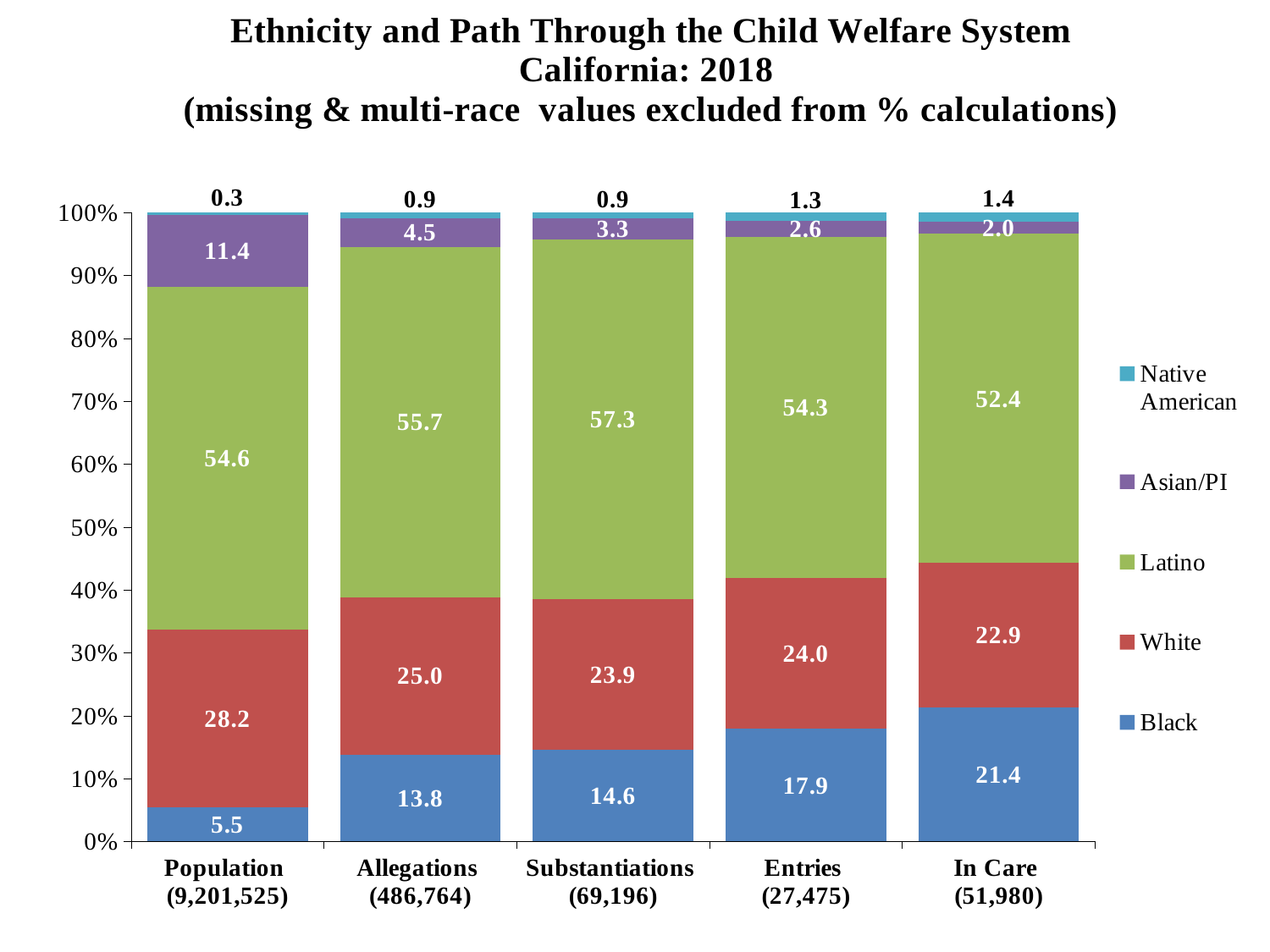
Does the Black share rise or fall from Population to In Care along the x axis? Rise What is the difference between the Black value for In Care and the Black value for Population? 15.9 Which is larger, the Latino value for Allegations or the Latino value for Entries? Allegations How many categories are shown on the x axis? 5 What is the value for Native American in the In Care bar? 1.4 What is the value for Asian/PI in the Population bar? 11.4 In which category is the Asian/PI share lowest? In Care How many series does the legend list? 5 What kind of chart is this? Stacked bar chart What is the value for Black in the Population bar? 5.5 What is the value for Latino in the Substantiations bar? 57.3 In which category is the Black share highest? In Care